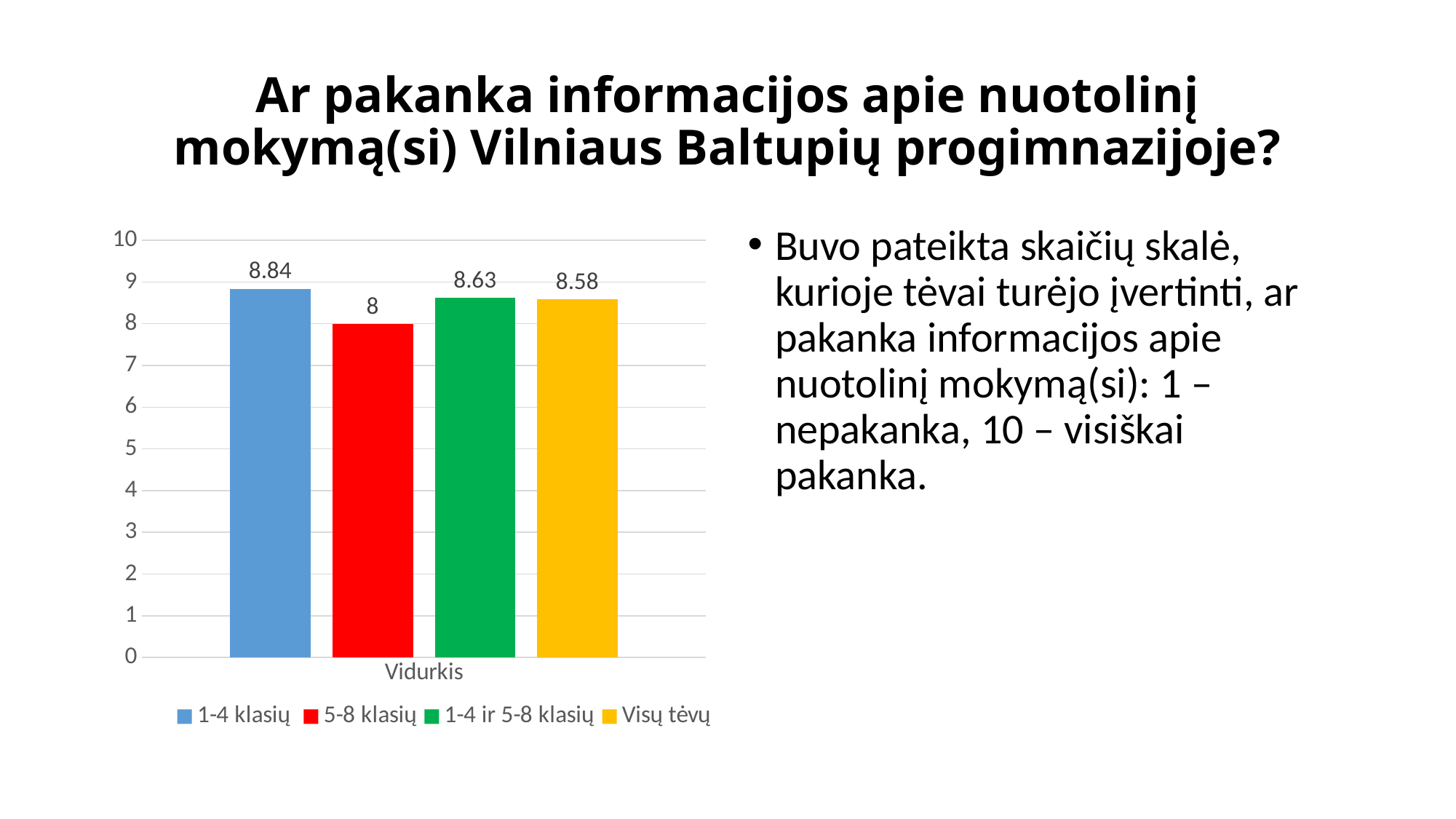
What kind of chart is shown on the slide? bar chart What colour is the bar for 5-8 klasių? red Which series has the lowest value? 5-8 klasių What is the value for 1-4 ir 5-8 klasių? 8.63 What is the difference between the values for 1-4 klasių and 5-8 klasių? 0.84 What is the label on the x axis category? Vidurkis What is the value for Visų tėvų? 8.58 What is the value for 1-4 klasių? 8.84 Which series has the highest value? 1-4 klasių How many series does the legend list? 4 Which is larger, the value for 1-4 klasių or the value for Visų tėvų? 1-4 klasių What is the value for 5-8 klasių? 8